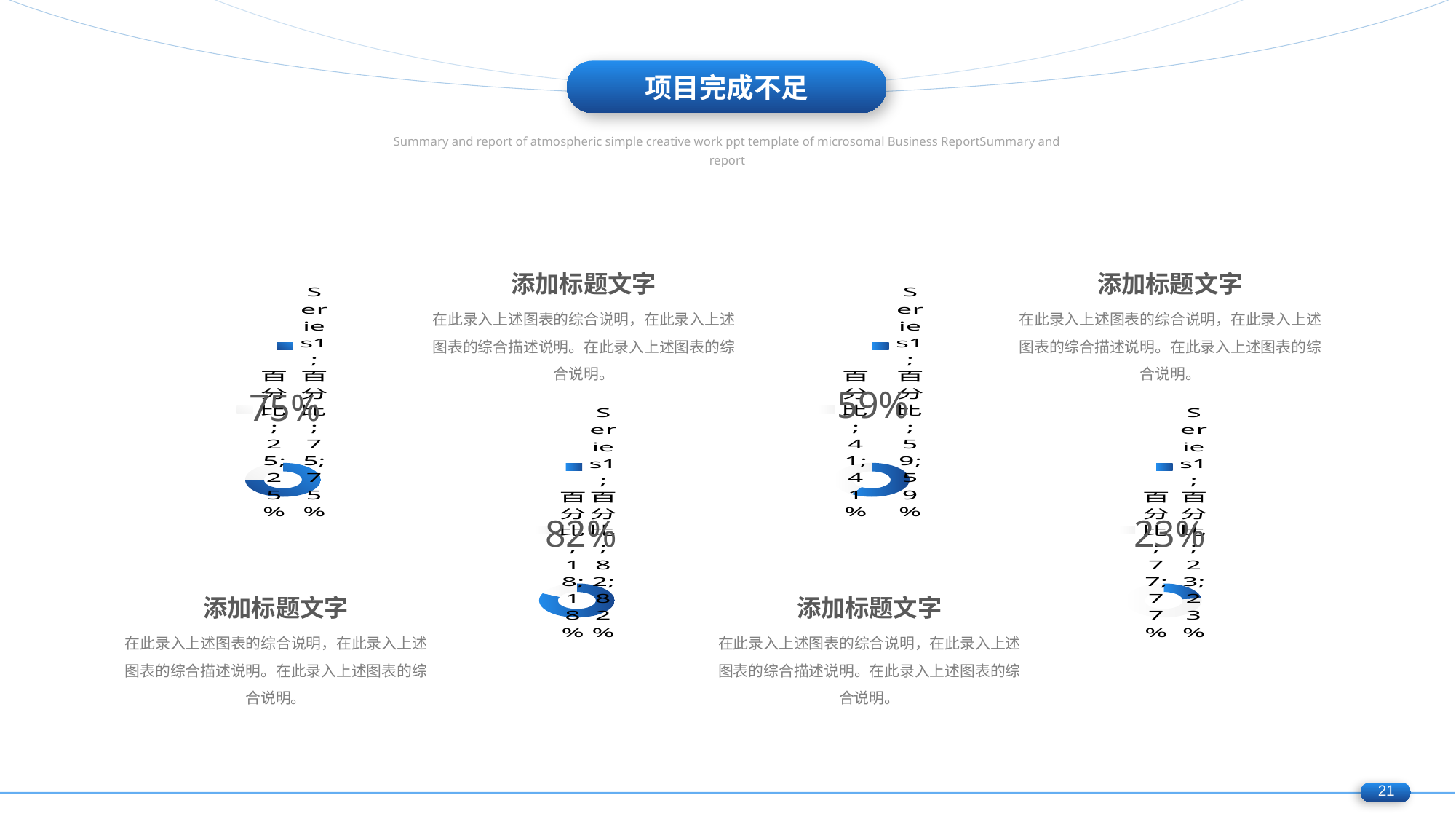
What is the difference between the percentage on the lower centre-left doughnut chart and the percentage on the rightmost doughnut chart? 59% Which doughnut chart shows the lowest percentage? the rightmost chart (23%) How many doughnut charts are on the slide? 4 What percentage is displayed on the leftmost doughnut chart? 75% What kind of chart is the chart labelled 75% on the left of the slide? doughnut chart What percentage is displayed on the doughnut chart in the lower centre-left of the slide? 82% Is the percentage shown on the rightmost doughnut chart greater or less than 50%? less What percentage is displayed on the rightmost doughnut chart? 23% Which doughnut chart shows the highest percentage? the lower centre-left chart (82%) Which is larger, the percentage on the leftmost doughnut chart or the percentage on the upper centre-right doughnut chart? the leftmost chart (75%) What percentage is displayed on the doughnut chart in the upper centre-right of the slide? 59% What colour is the filled portion of the doughnut charts? blue